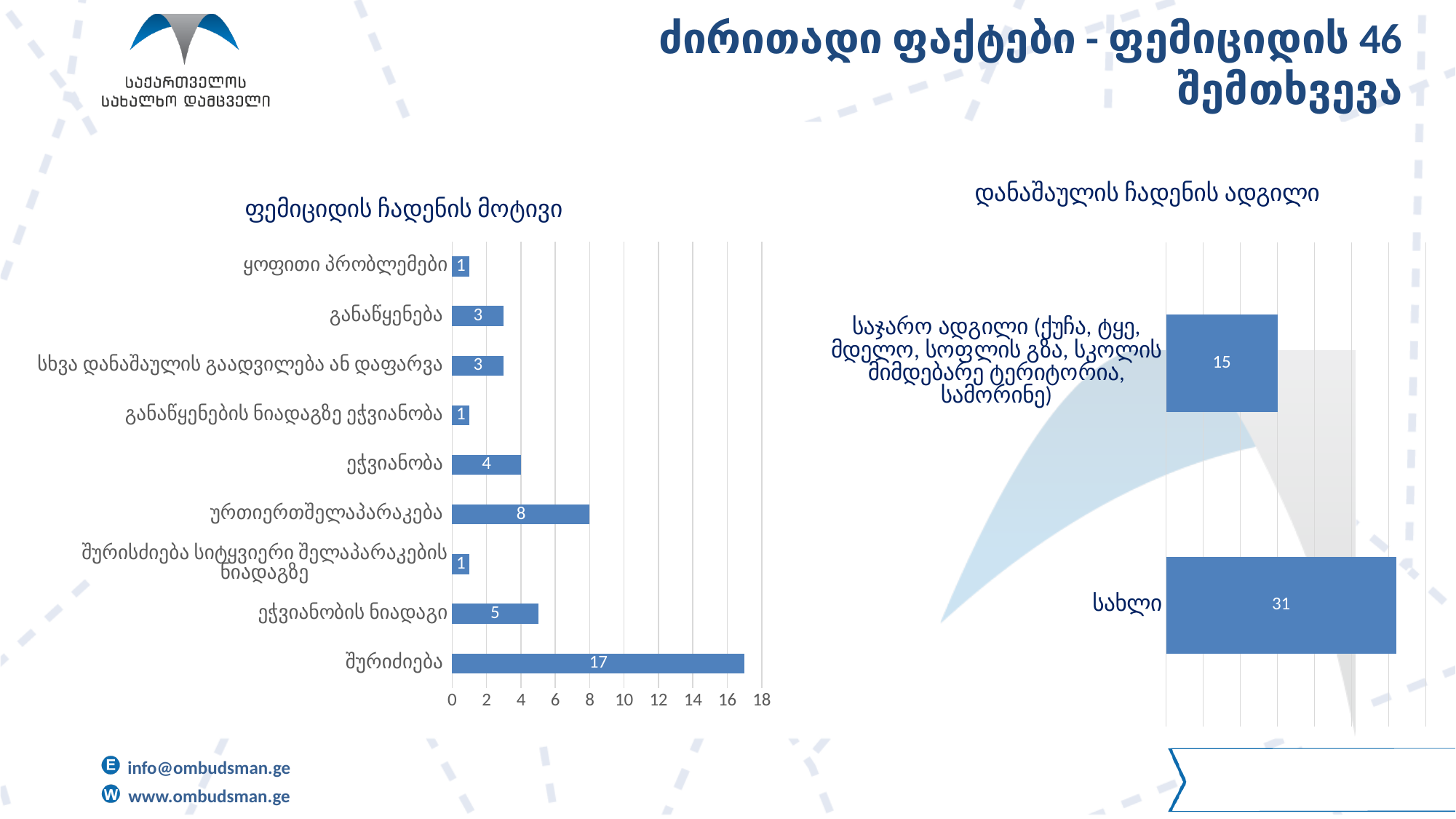
In the chart titled "ფემიციდის ჩადენის მოტივი", what is the value for "ურთიერთშელაპარაკება"? 8 In the chart titled "ფემიციდის ჩადენის მოტივი", what is the value for "ეჭვიანობის ნიადაგი"? 5 In the chart titled "ფემიციდის ჩადენის მოტივი", what is the difference between "შურიძიება" and "ურთიერთშელაპარაკება"? 9 In the chart titled "ფემიციდის ჩადენის მოტივი", which category has the highest value? შურიძიება In the chart titled "დანაშაულის ჩადენის ადგილი", what is the value for "სახლი"? 31 In the chart titled "ფემიციდის ჩადენის მოტივი", which is larger: "ეჭვიანობა" or "განაწყენება"? ეჭვიანობა In the chart titled "დანაშაულის ჩადენის ადგილი", what is the difference between "სახლი" and "საჯარო ადგილი"? 16 In the chart titled "დანაშაულის ჩადენის ადგილი", what is the value for the "საჯარო ადგილი" category? 15 How many categories are shown in the chart titled "ფემიციდის ჩადენის მოტივი"? 9 How many categories are shown in the chart titled "დანაშაულის ჩადენის ადგილი"? 2 In the chart titled "ფემიციდის ჩადენის მოტივი", what is the value for "შურიძიება"? 17 What type of chart is the chart titled "ფემიციდის ჩადენის მოტივი"? bar chart